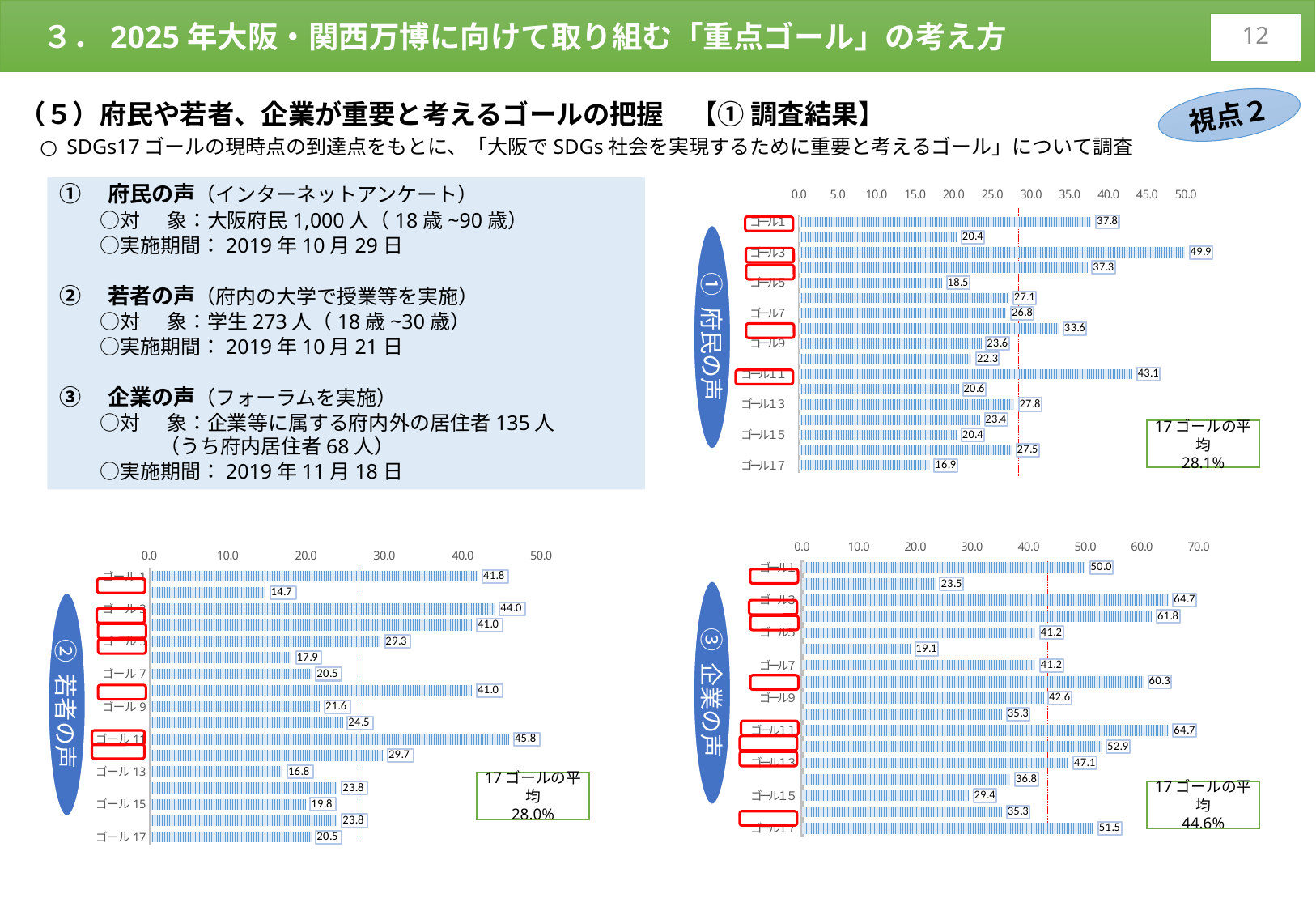
What kind of chart is the ③ 企業の声 chart (bottom right)? bar chart How many goals (categories) are plotted in the ② 若者の声 chart (bottom left)? 17 In the ① 府民の声 chart (top right), which goal has the lowest value? ゴール17 In the ② 若者の声 chart (bottom left), what is the value for ゴール11? 45.8 In the ① 府民の声 chart (top right), which goal has the highest value? ゴール3 What is the 17-goal average (17ゴールの平均) shown in the box next to the ③ 企業の声 chart (bottom right)? 44.6% In the ② 若者の声 chart (bottom left), what is the difference between the values for ゴール3 and ゴール1? 2.2 In the ③ 企業の声 chart (bottom right), what is the value for ゴール17? 51.5 In the ③ 企業の声 chart (bottom right), what is the difference between the values for ゴール17 and ゴール1? 1.5 In the ① 府民の声 chart (top right), is the value for ゴール7 greater or less than 30.0? less In the ① 府民の声 chart (top right), what is the value for ゴール1? 37.8 In the ③ 企業の声 chart (bottom right), which is larger, the value for ゴール13 or ゴール15? ゴール13